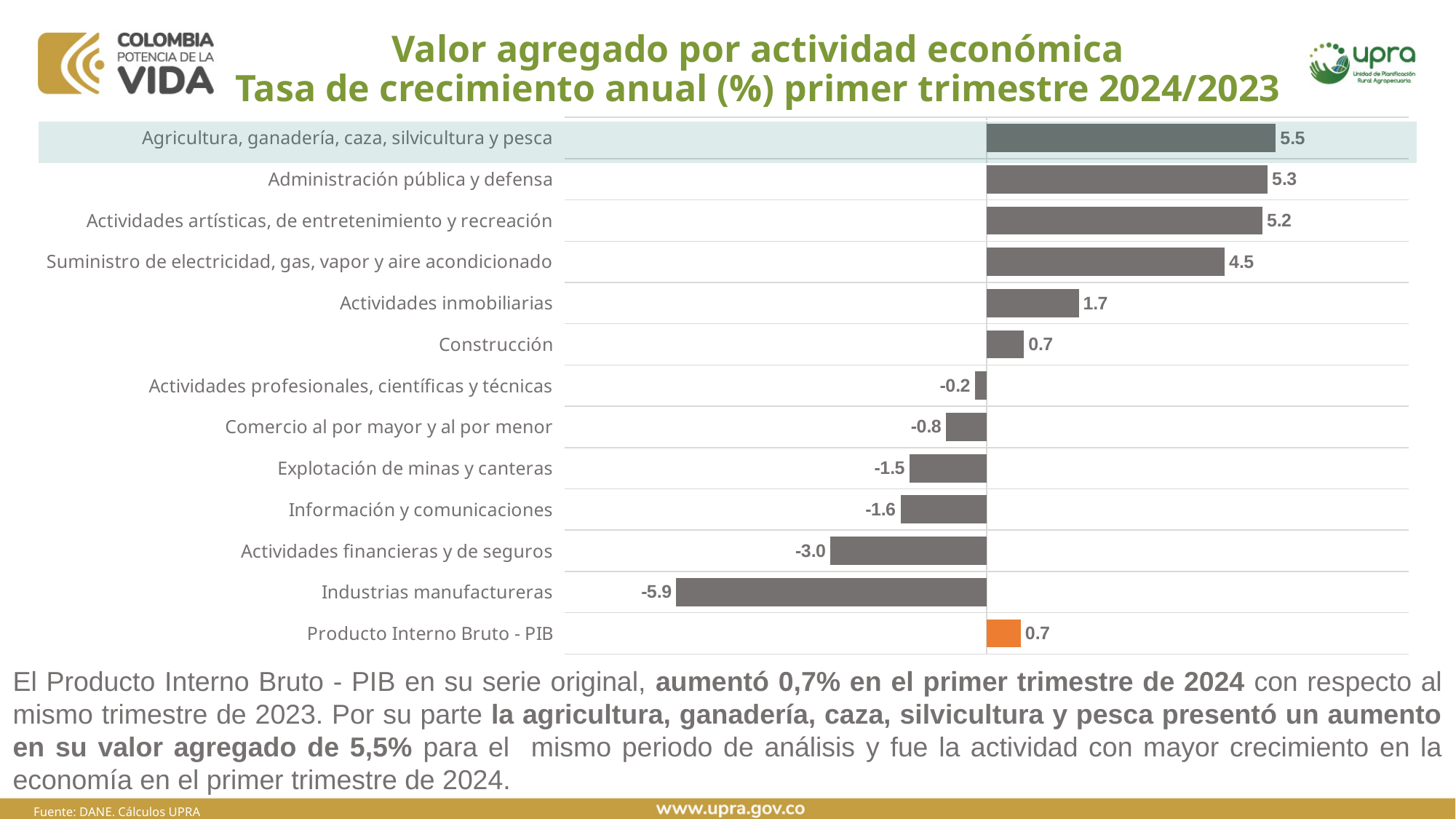
What is the value shown for Actividades financieras y de seguros? -3.0 What is the difference between the value for Agricultura, ganadería, caza, silvicultura y pesca and the value for Producto Interno Bruto - PIB? 4.8 Which has a higher value: Administración pública y defensa or Suministro de electricidad, gas, vapor y aire acondicionado? Administración pública y defensa What type of chart is shown on the slide? Bar chart Which activity has the highest growth rate in the chart? Agricultura, ganadería, caza, silvicultura y pesca What is the growth rate shown for Agricultura, ganadería, caza, silvicultura y pesca? 5.5 What is the value shown for Industrias manufactureras? -5.9 How many bars (categories) are plotted in the chart? 13 Which activity has the lowest growth rate in the chart? Industrias manufactureras What is the value shown for Producto Interno Bruto - PIB? 0.7 Which bar in the chart is coloured orange instead of grey? Producto Interno Bruto - PIB How many categories in the chart have a negative value? 6